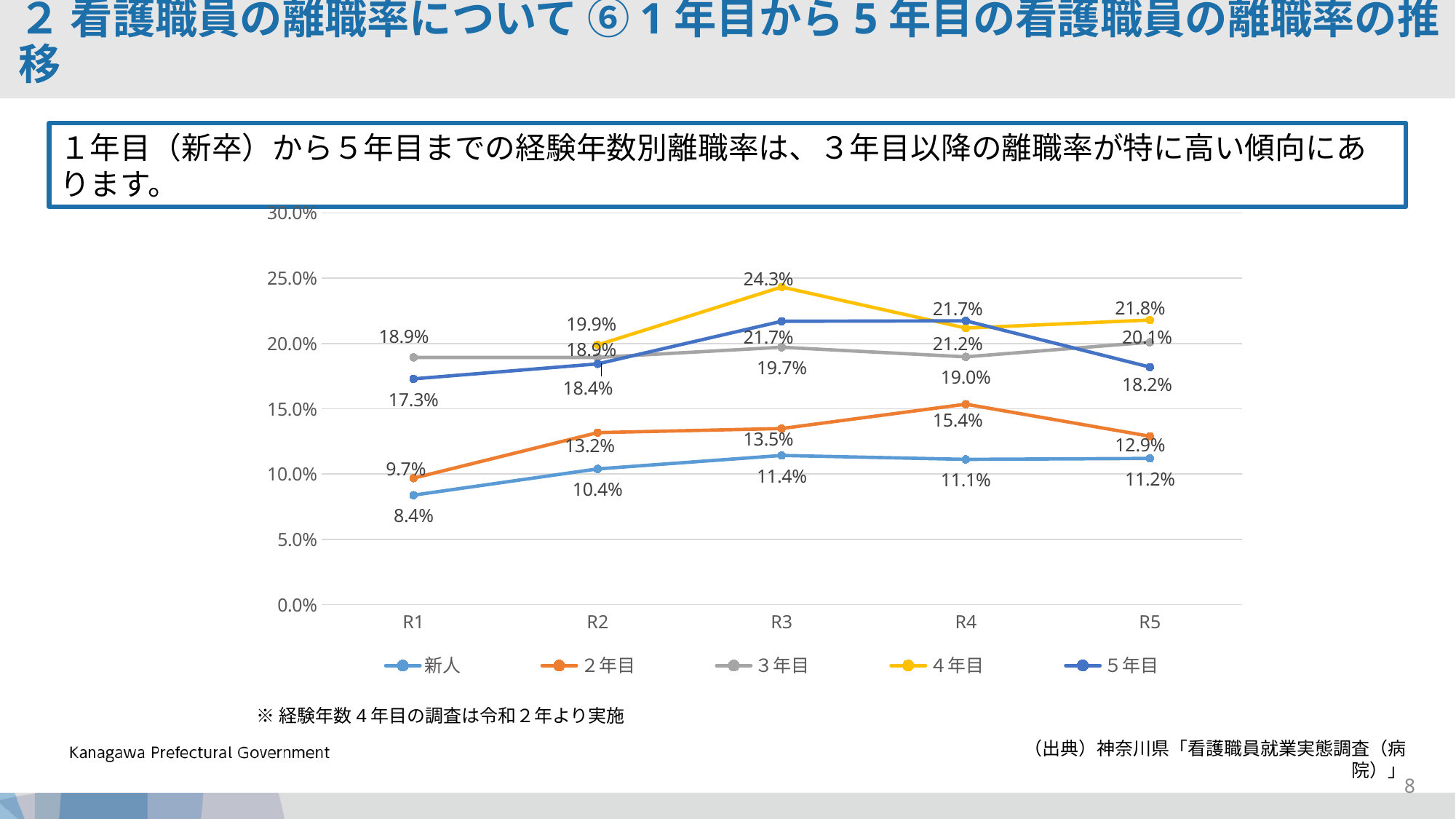
Which series has the highest value on the chart, and at which year? 4年目 at R3 (24.3%) What is the value for 5年目 at R5? 18.2% What is the value for 新人 at R1? 8.4% Does the 新人 series rise or fall from R1 to R3? Rise What is the value for 2年目 at R4? 15.4% Which series has the lowest value on the chart, and at which year? 新人 at R1 (8.4%) How many years are shown on the x axis? 5 How many series does the legend list? 5 What is the difference between the 2年目 value at R4 and at R1? 5.7 percentage points What kind of chart is shown on the slide? Line chart What is the value for 4年目 at R3? 24.3% At R5, which is larger: the value for 3年目 or the value for 5年目? 3年目